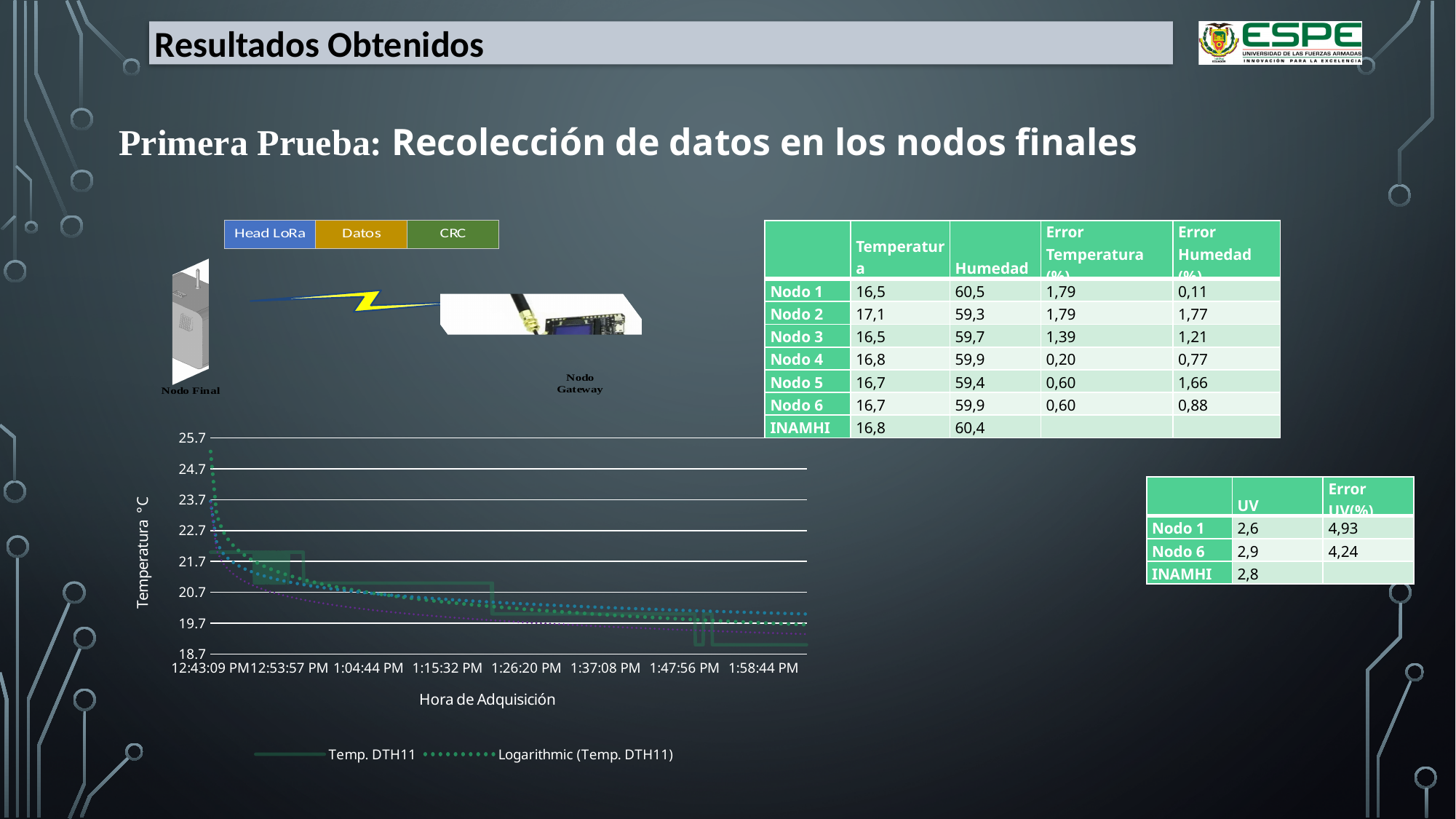
How many time labels are shown on the x axis of the chart? 8 Do the Temp. DTH11 values rise or fall along the x axis over the acquisition period? fall Is the Temp. DTH11 value at 12:43:09 PM greater or less than 20.7? greater What kind of chart is shown on the slide? line chart What are the two entries listed in the chart legend? Temp. DTH11 and Logarithmic (Temp. DTH11) How many series does the chart legend list? 2 What is the title of the x axis of the chart? Hora de Adquisición Is the Temp. DTH11 value at 1:58:44 PM greater or less than 20.7? less